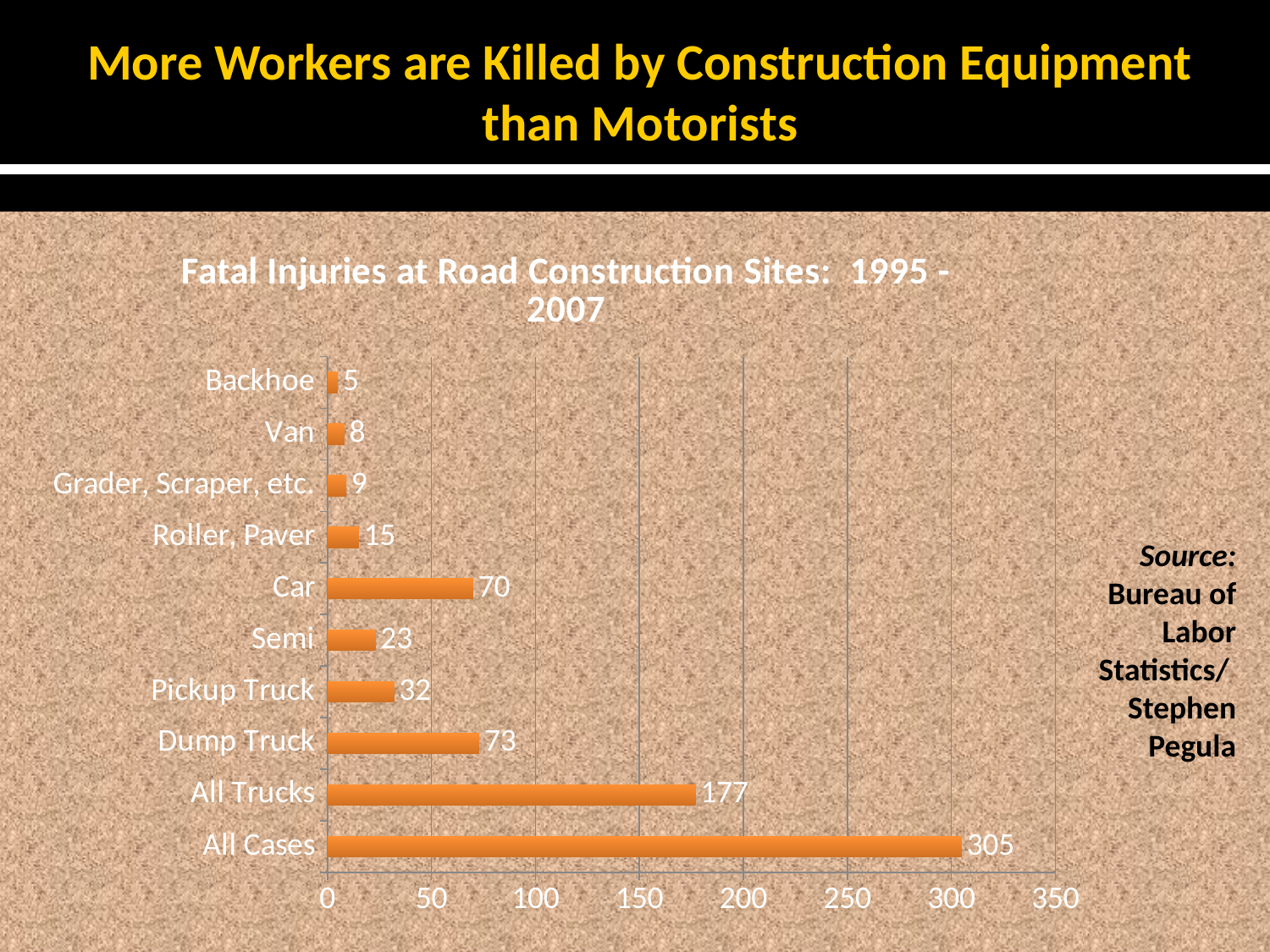
Is the value for All Trucks greater or less than 150? greater What is the value for Dump Truck? 73 What is the value for Car? 70 What is the title of the chart? Fatal Injuries at Road Construction Sites: 1995 - 2007 What is the difference between All Cases and All Trucks? 128 What kind of chart is shown on the slide? bar chart How many categories are shown in the chart? 10 What is the difference between Pickup Truck and Semi? 9 What is the value for Roller, Paver? 15 Which category has the highest value? All Cases Which is larger, Dump Truck or Pickup Truck? Dump Truck Which category has the lowest value? Backhoe